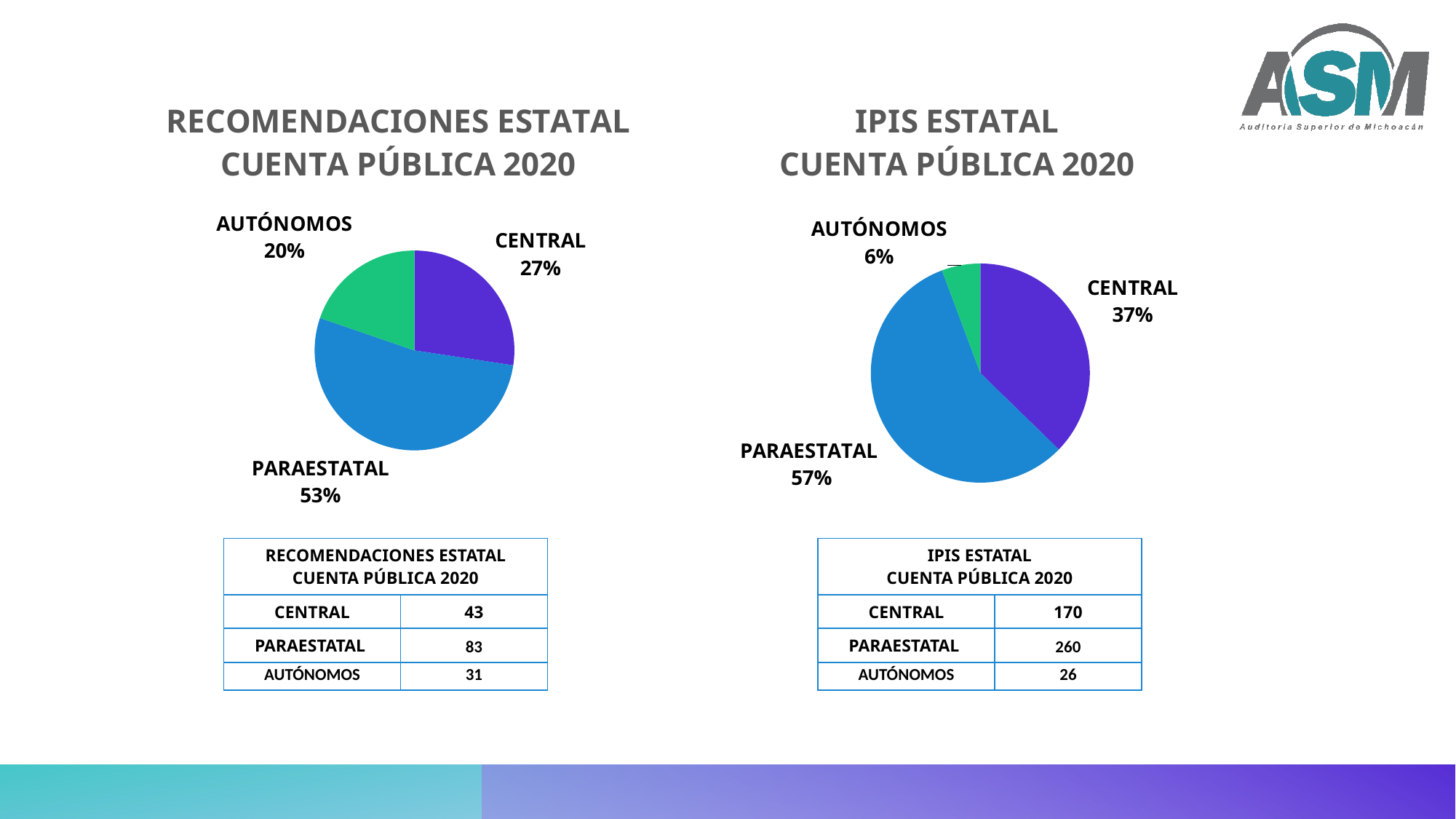
In the 'IPIS ESTATAL CUENTA PÚBLICA 2020' pie chart, what share does AUTÓNOMOS have? 6% What type of chart is used for 'RECOMENDACIONES ESTATAL CUENTA PÚBLICA 2020'? Pie chart In the 'RECOMENDACIONES ESTATAL CUENTA PÚBLICA 2020' pie chart, which category has the largest slice? PARAESTATAL In the 'IPIS ESTATAL CUENTA PÚBLICA 2020' pie chart, which category has the smallest slice? AUTÓNOMOS In the 'RECOMENDACIONES ESTATAL CUENTA PÚBLICA 2020' pie chart, what share does PARAESTATAL have? 53% In the 'RECOMENDACIONES ESTATAL CUENTA PÚBLICA 2020' pie chart, which category has the smallest slice? AUTÓNOMOS How many categories does the 'IPIS ESTATAL CUENTA PÚBLICA 2020' pie chart show? 3 In the 'IPIS ESTATAL CUENTA PÚBLICA 2020' pie chart, what share does CENTRAL have? 37% In the 'IPIS ESTATAL CUENTA PÚBLICA 2020' pie chart, which is larger, CENTRAL or PARAESTATAL? PARAESTATAL In the 'RECOMENDACIONES ESTATAL CUENTA PÚBLICA 2020' pie chart, what is the difference in percentage points between PARAESTATAL and CENTRAL? 26 In the 'IPIS ESTATAL CUENTA PÚBLICA 2020' pie chart, what is the difference in percentage points between PARAESTATAL and AUTÓNOMOS? 51